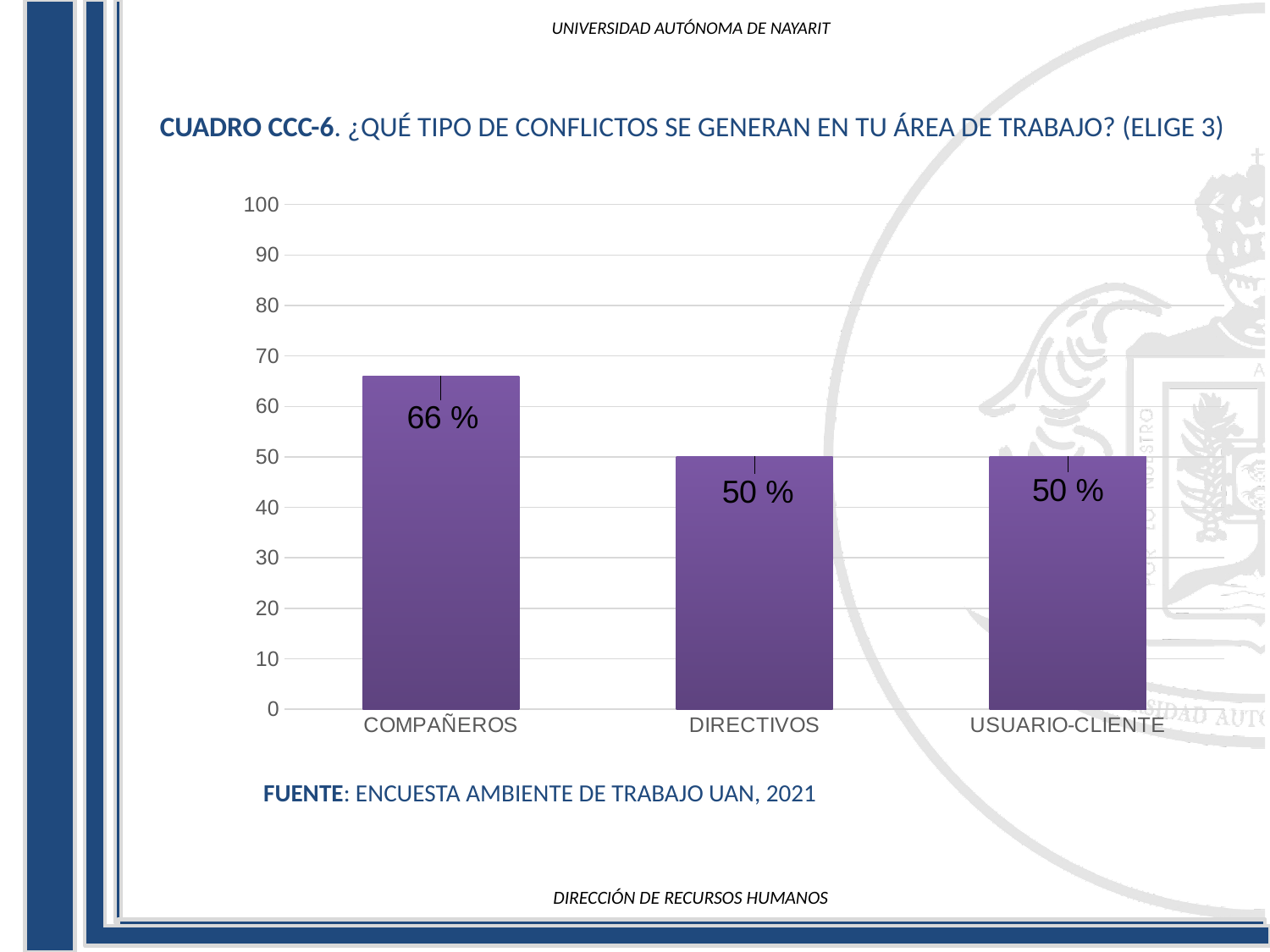
Which is larger, the value for COMPAÑEROS or the value for USUARIO-CLIENTE? COMPAÑEROS What source is cited below the chart? ENCUESTA AMBIENTE DE TRABAJO UAN, 2021 What is the difference between the values for COMPAÑEROS and DIRECTIVOS? 16 % What is the value for USUARIO-CLIENTE? 50 % How many categories are shown on the x axis? 3 What is the value for COMPAÑEROS? 66 % Is the value for COMPAÑEROS greater or less than 60? greater Is the value for DIRECTIVOS greater or less than 70? less What is the highest value shown on the y axis? 100 What kind of chart is shown on the slide? bar chart Which category has the highest value? COMPAÑEROS What is the value for DIRECTIVOS? 50 %